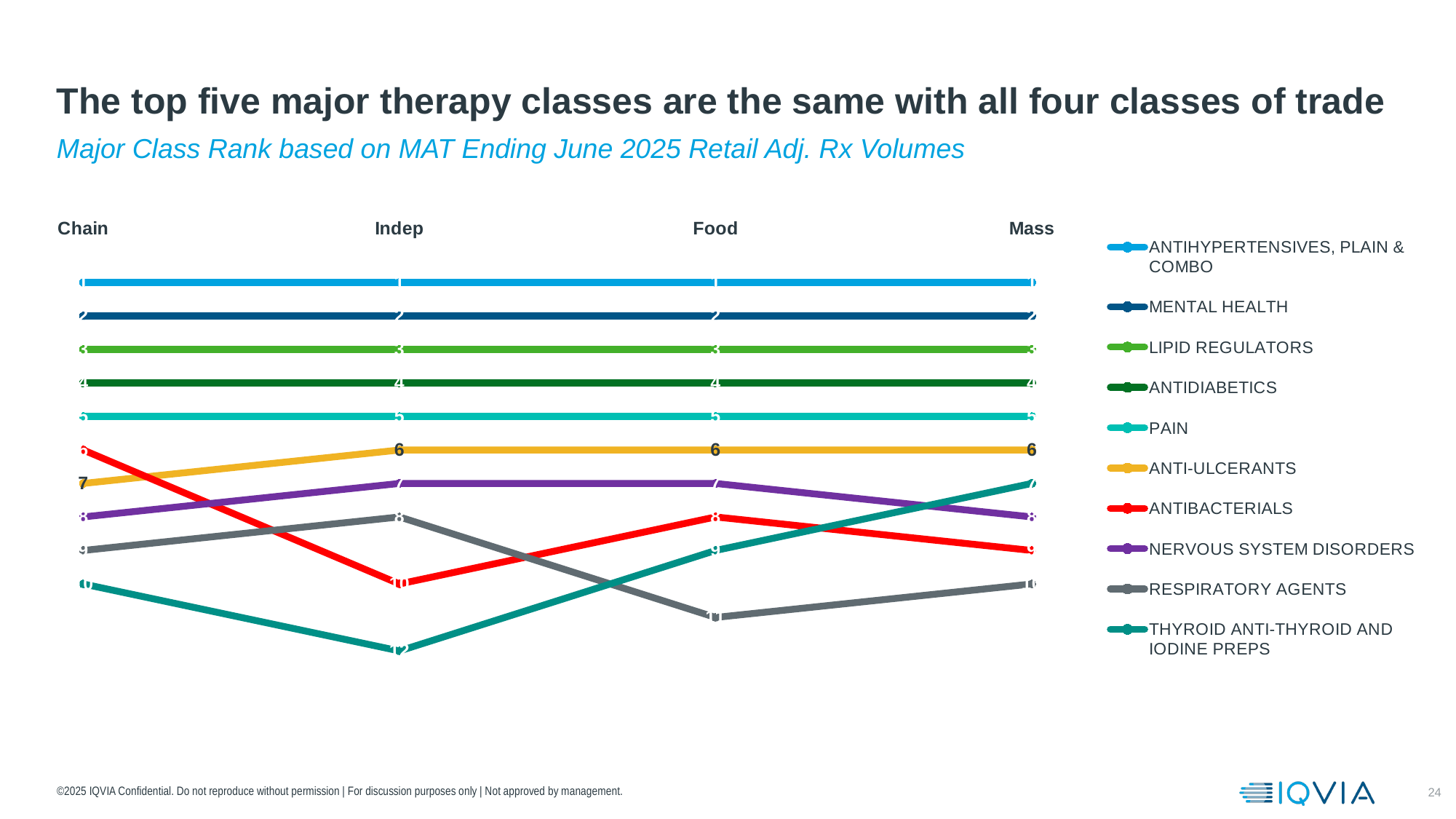
What kind of chart is shown on the slide? line chart What is the rank of RESPIRATORY AGENTS for Food? 11 What is the rank of ANTI-ULCERANTS for Indep? 6 What is the rank of THYROID ANTI-THYROID AND IODINE PREPS for Mass? 7 How many classes of trade are shown along the x axis? 4 Does the rank number for THYROID ANTI-THYROID AND IODINE PREPS increase or decrease from Indep to Mass? decrease What is the rank of ANTIBACTERIALS for Indep? 10 What colour is the ANTIBACTERIALS line in the legend? red How many series does the legend list? 10 What is the rank of ANTI-ULCERANTS for Chain? 7 Which therapy class holds rank 1 for all four classes of trade? ANTIHYPERTENSIVES, PLAIN & COMBO What is the rank of THYROID ANTI-THYROID AND IODINE PREPS for Indep? 12